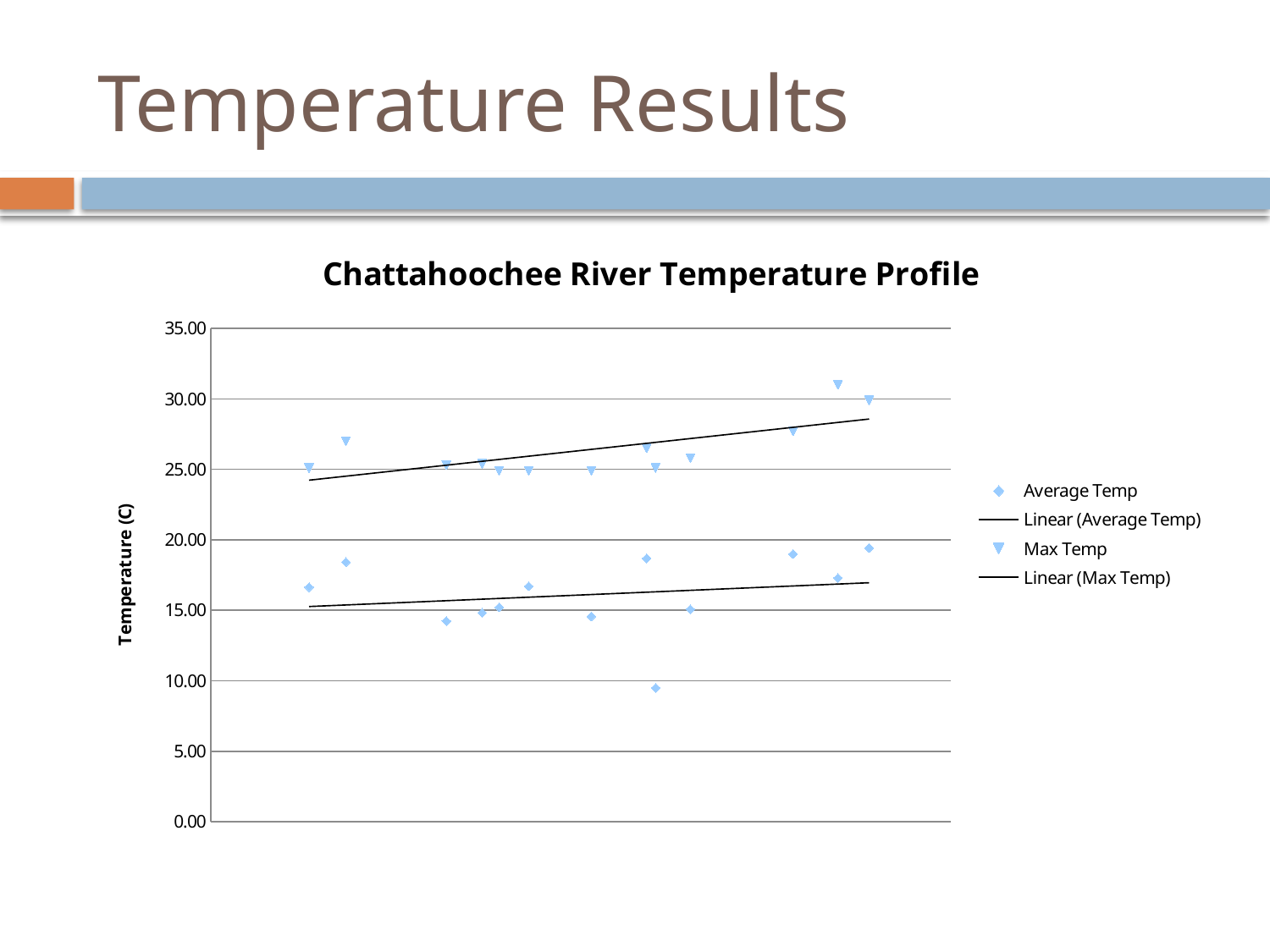
What is the highest value shown on the vertical axis of the chart? 35.00 Is the lowest Average Temp point greater or less than 10.00? less Are all of the Average Temp points greater or less than 25.00? less Does the Linear (Max Temp) trendline rise or fall from left to right? rise Which series has the higher values overall, Average Temp or Max Temp? Max Temp What is the label on the vertical axis of the chart? Temperature (C) What is the title of the chart? Chattahoochee River Temperature Profile How many entries does the chart's legend list? 4 Does the Linear (Average Temp) trendline rise or fall from left to right? rise Is the highest Max Temp point greater or less than 30.00? greater What kind of chart is shown on the slide? scatter chart